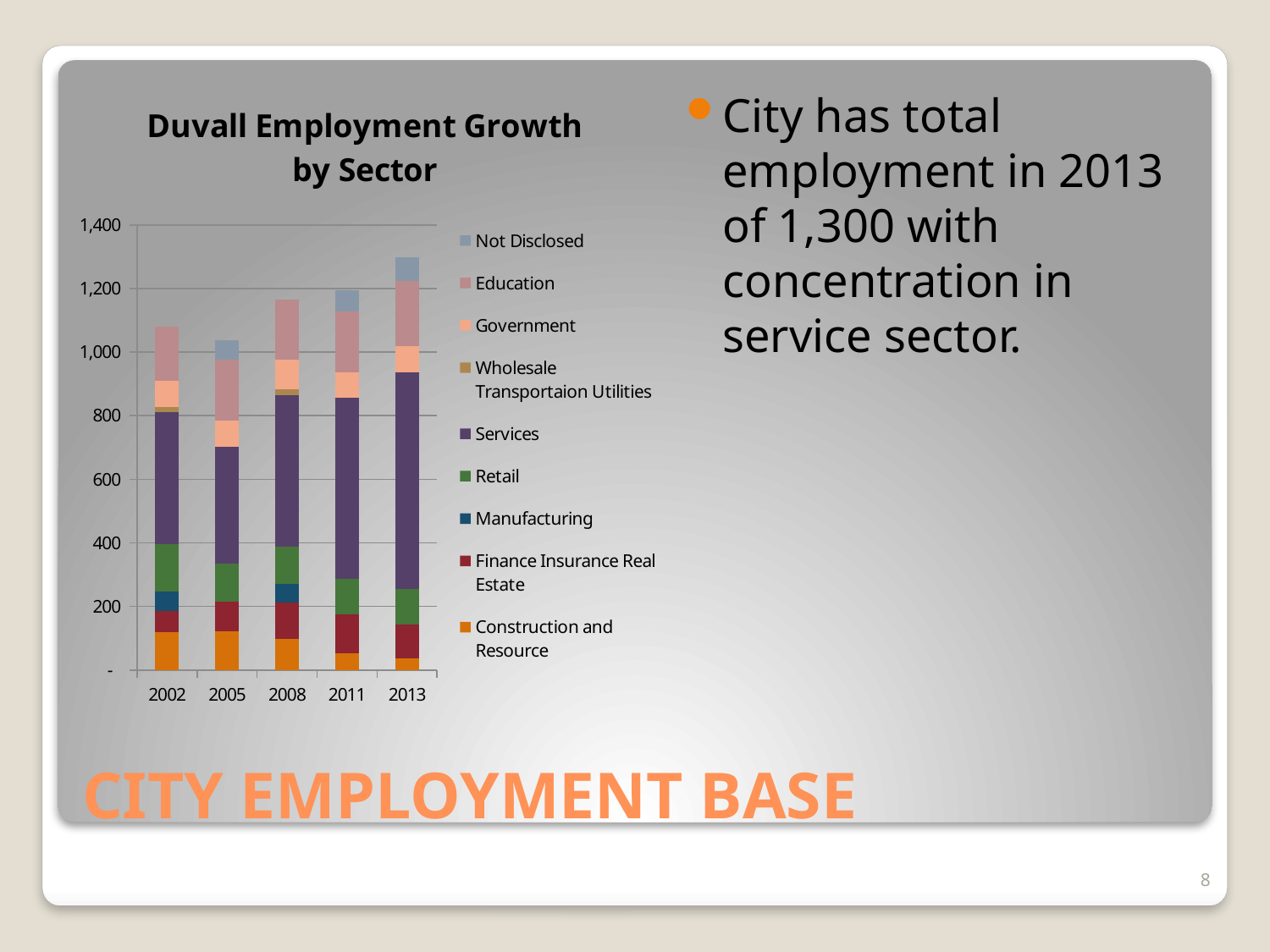
How many years (bars) are shown on the x axis of the chart? 5 Which is larger, the total employment in 2013 or in 2002? 2013 How many series does the chart's legend list? 9 Is the total employment for 2002 greater or less than 1,200? less Do the total employment values generally rise or fall from 2002 to 2013? rise What kind of chart is shown on the slide? Stacked bar chart Which year has the highest total employment in the chart? 2013 What is the title of the chart? Duvall Employment Growth by Sector Which is larger, the Construction and Resource segment in 2002 or in 2013? 2002 Is the total employment for 2013 greater or less than 1,200? greater Which sector makes up the largest segment of each bar in the chart? Services Is the total employment for 2002 greater or less than 1,000? greater